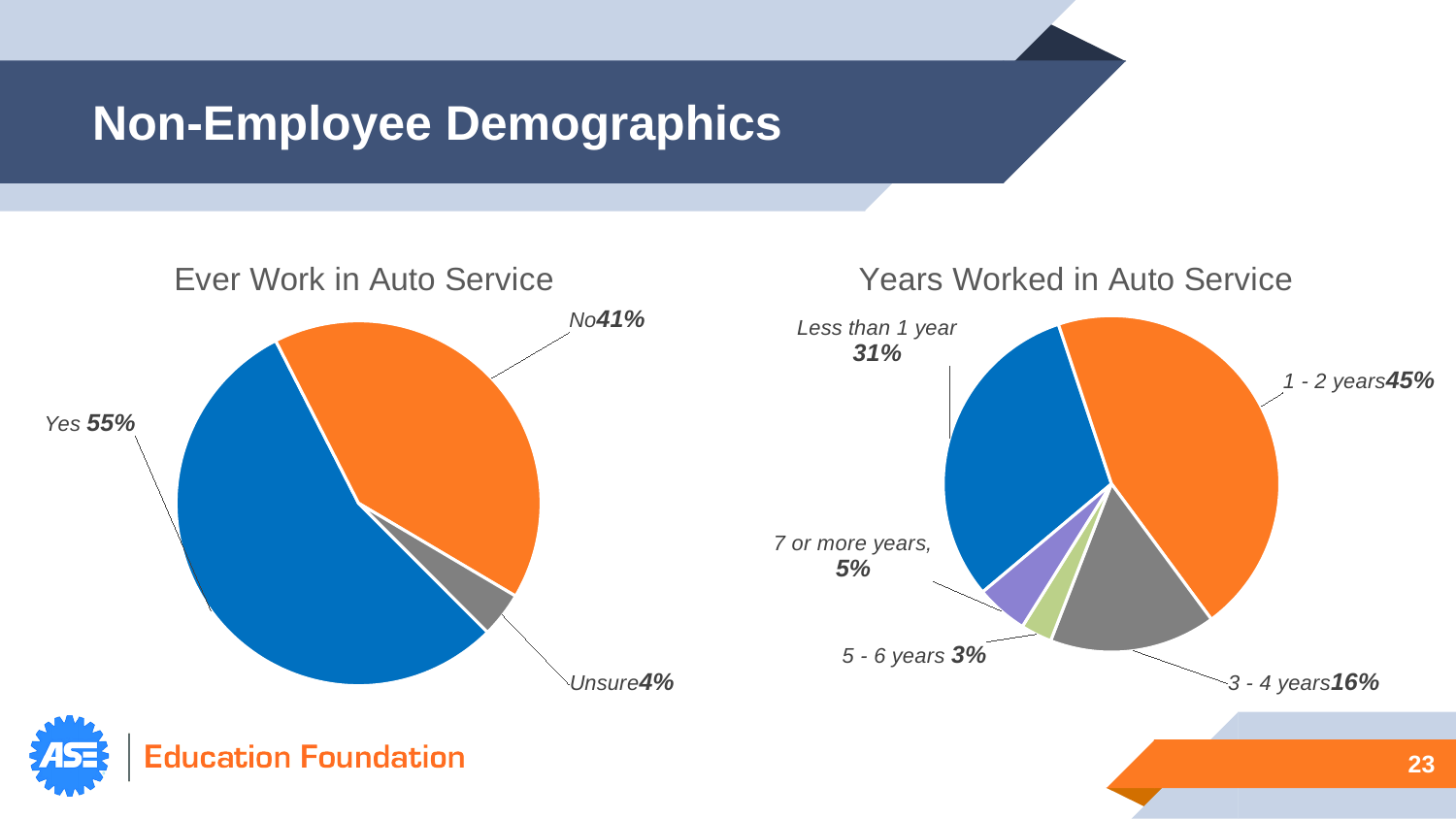
In the 'Ever Work in Auto Service' chart, what percentage answered Yes? 55% In the 'Ever Work in Auto Service' chart, which category has the largest share? Yes In the 'Years Worked in Auto Service' chart, what percentage worked 7 or more years? 5% In the 'Years Worked in Auto Service' chart, which is larger: Less than 1 year or 3 - 4 years? Less than 1 year In the 'Years Worked in Auto Service' chart, what percentage worked 1 - 2 years? 45% What type of chart is used for 'Years Worked in Auto Service'? Pie chart In the 'Years Worked in Auto Service' chart, which category has the smallest share? 5 - 6 years In the 'Ever Work in Auto Service' chart, what is the difference between the Yes and No shares? 14% In the 'Ever Work in Auto Service' chart, what percentage answered Unsure? 4% In the 'Ever Work in Auto Service' chart, how many slices does the pie have? 3 In the 'Years Worked in Auto Service' chart, how many categories are shown? 5 In the 'Years Worked in Auto Service' chart, what is the difference between the 1 - 2 years and Less than 1 year shares? 14%